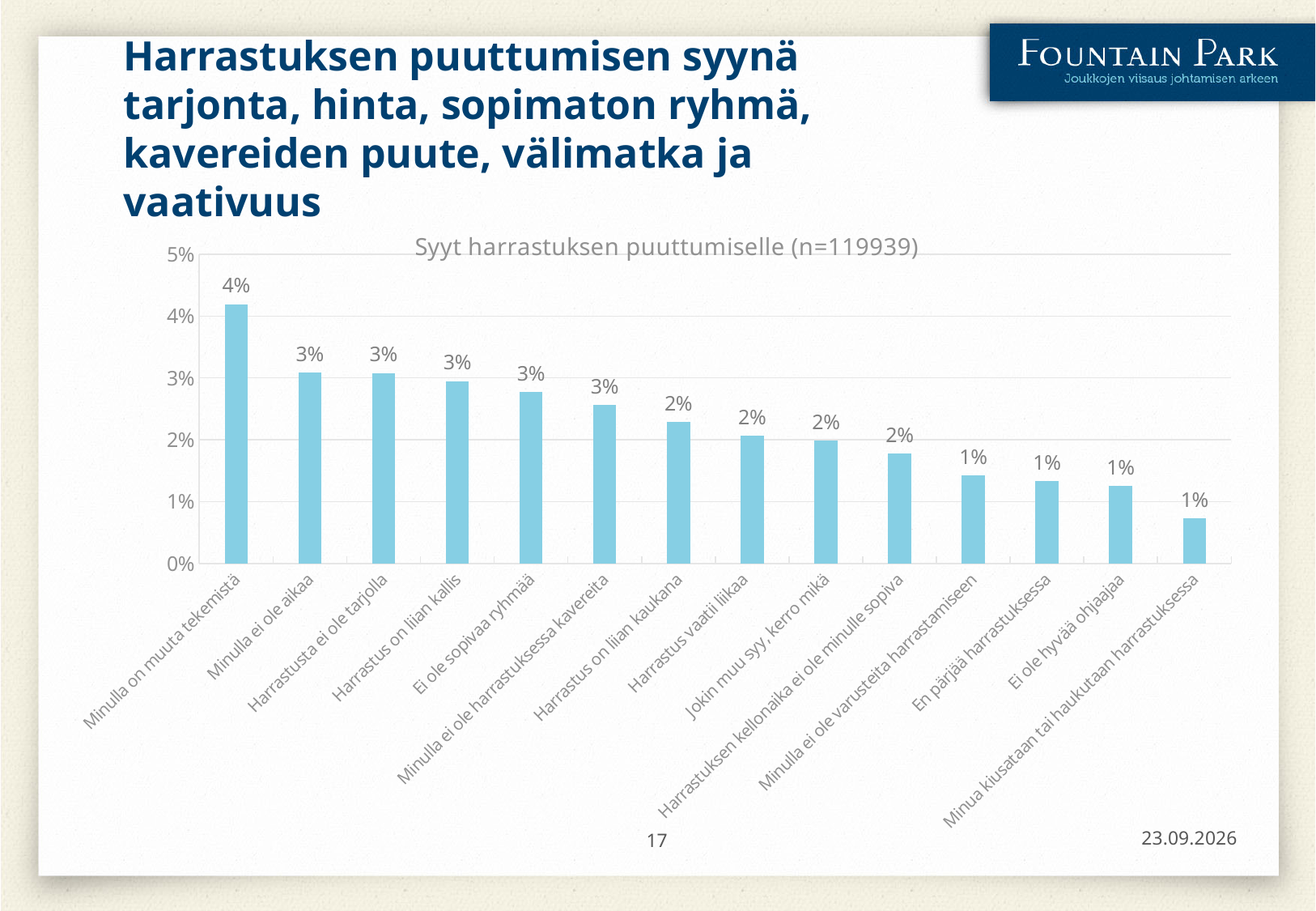
What is the difference between the labelled values for "Minulla on muuta tekemistä" and "En pärjää harrastuksessa"? 3% What value is shown for "Ei ole hyvää ohjaajaa"? 1% Which category has the lowest value? Minua kiusataan tai haukutaan harrastuksessa What is the title of the chart? Syyt harrastuksen puuttumiselle (n=119939) What kind of chart is shown on the slide? bar chart Which category has the highest value? Minulla on muuta tekemistä Do the values rise or fall from left to right along the x axis? fall What value is shown for "Harrastus on liian kaukana"? 2% What value is shown for "Minulla on muuta tekemistä"? 4% Which is larger, the value for "Minulla ei ole aikaa" or the value for "Minulla ei ole varusteita harrastamiseen"? Minulla ei ole aikaa Is the value for "Harrastus on liian kaukana" greater or less than 3%? less How many categories are shown on the x axis? 14